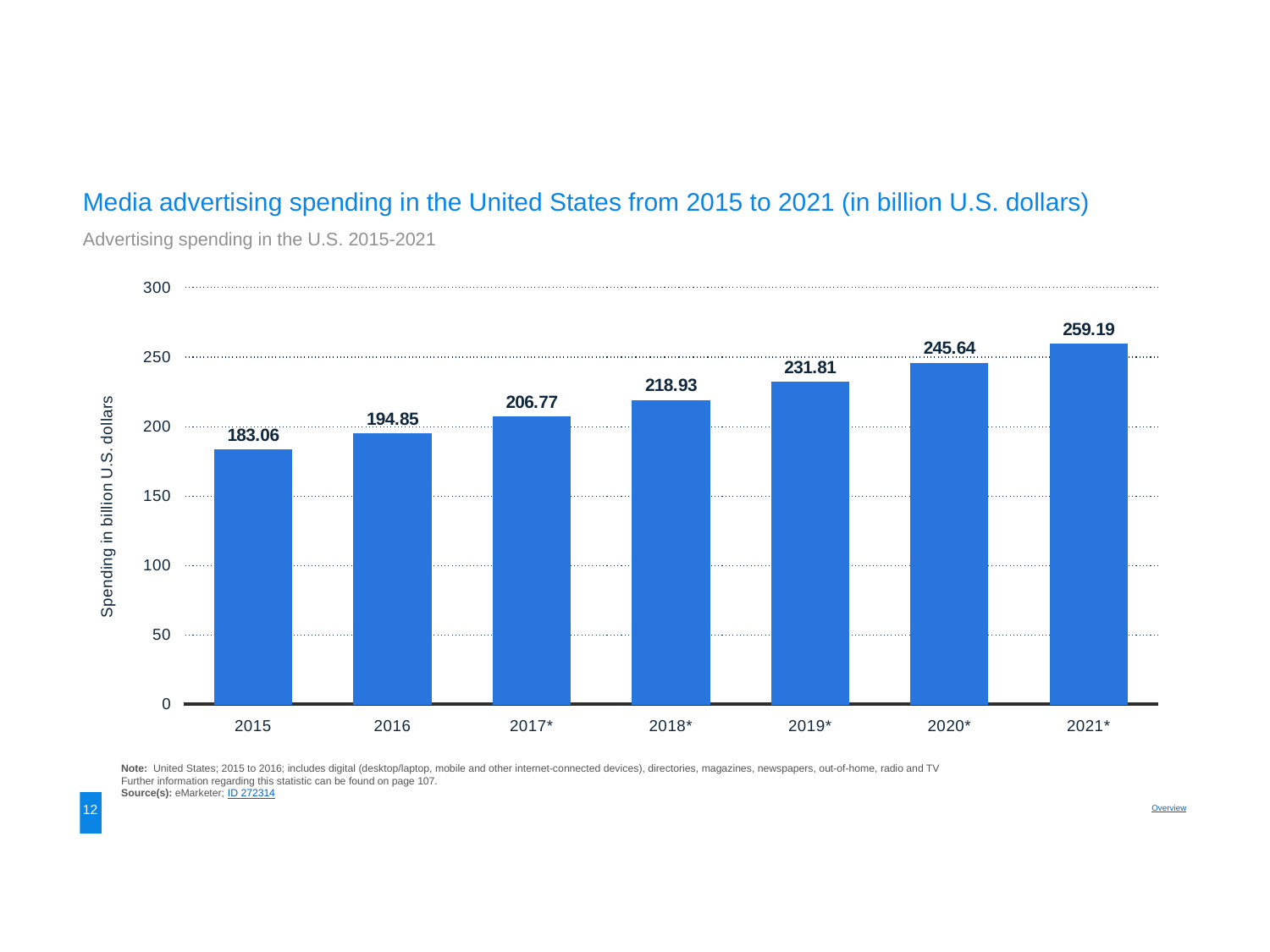
What is the value shown for 2020*? 245.64 How many years are shown on the x axis? 7 Which year has the lowest advertising spending? 2015 What is the media advertising spending value for 2015? 183.06 What kind of chart is shown on the slide? bar chart What is the value shown for 2018*? 218.93 Which is larger, the value for 2019* or the value for 2018*? 2019* What is the difference between the values for 2017* and 2016? 11.92 Do the values rise or fall from 2015 to 2021*? rise What is the difference between the values for 2021* and 2015? 76.13 Which year has the highest advertising spending? 2021* Is the value for 2016 greater or less than 200? less